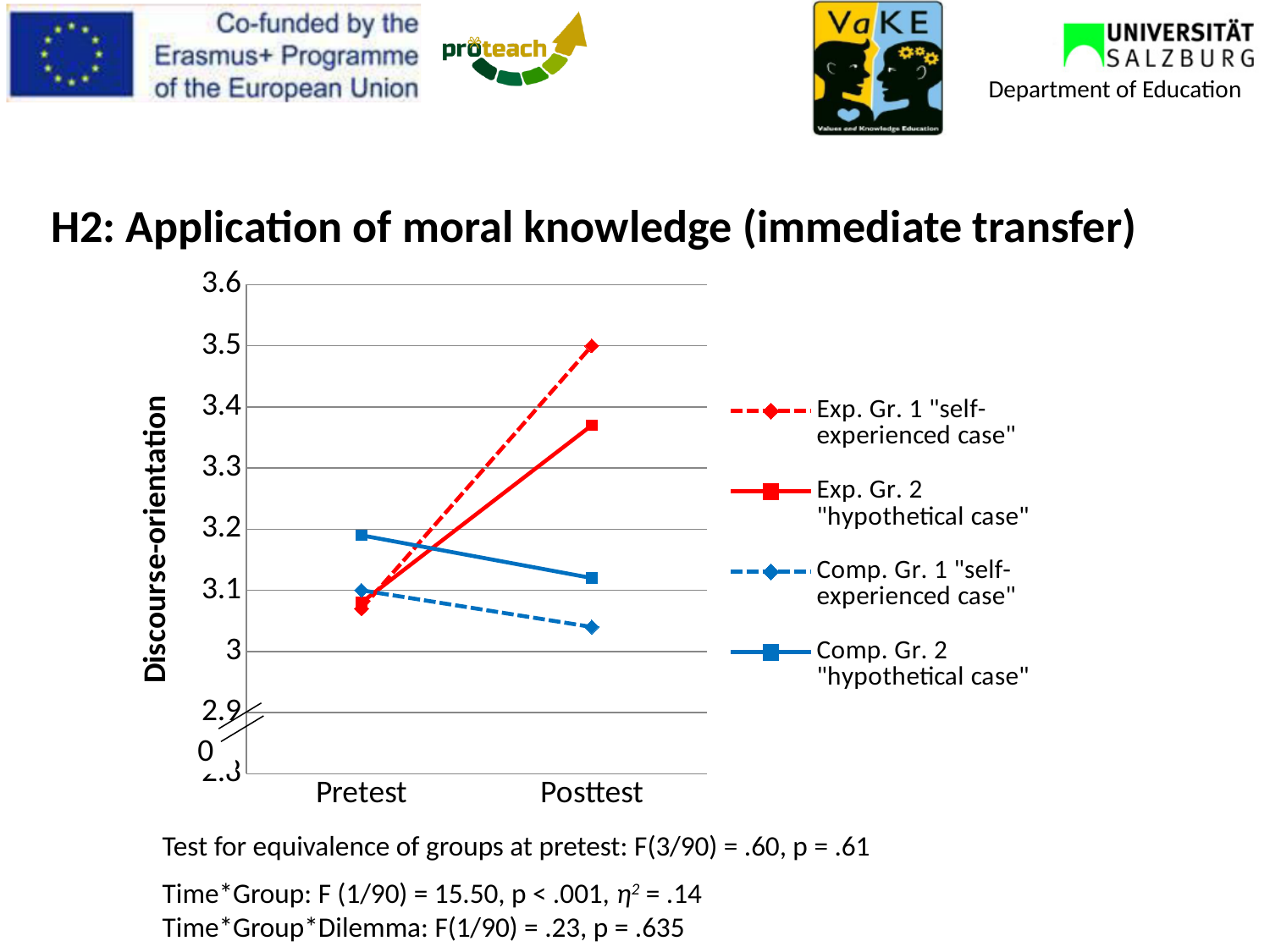
What is the label of the y axis? Discourse-orientation What kind of chart is shown on the slide? line chart How many series does the legend list? 4 Which group has the highest value at Posttest? Exp. Gr. 1 "self-experienced case" Does the value for Exp. Gr. 2 "hypothetical case" rise or fall from Pretest to Posttest? rise Which group has the lowest value at Posttest? Comp. Gr. 1 "self-experienced case" How many time points are shown on the x axis? 2 At Pretest, which is larger: the value for Comp. Gr. 2 "hypothetical case" or for Exp. Gr. 2 "hypothetical case"? Comp. Gr. 2 "hypothetical case" Is the Pretest value for Comp. Gr. 2 "hypothetical case" greater or less than 3.1? greater Does the value for Comp. Gr. 1 "self-experienced case" rise or fall from Pretest to Posttest? fall Is the Posttest value for Exp. Gr. 2 "hypothetical case" greater or less than 3.3? greater Which group has the highest value at Pretest? Comp. Gr. 2 "hypothetical case"